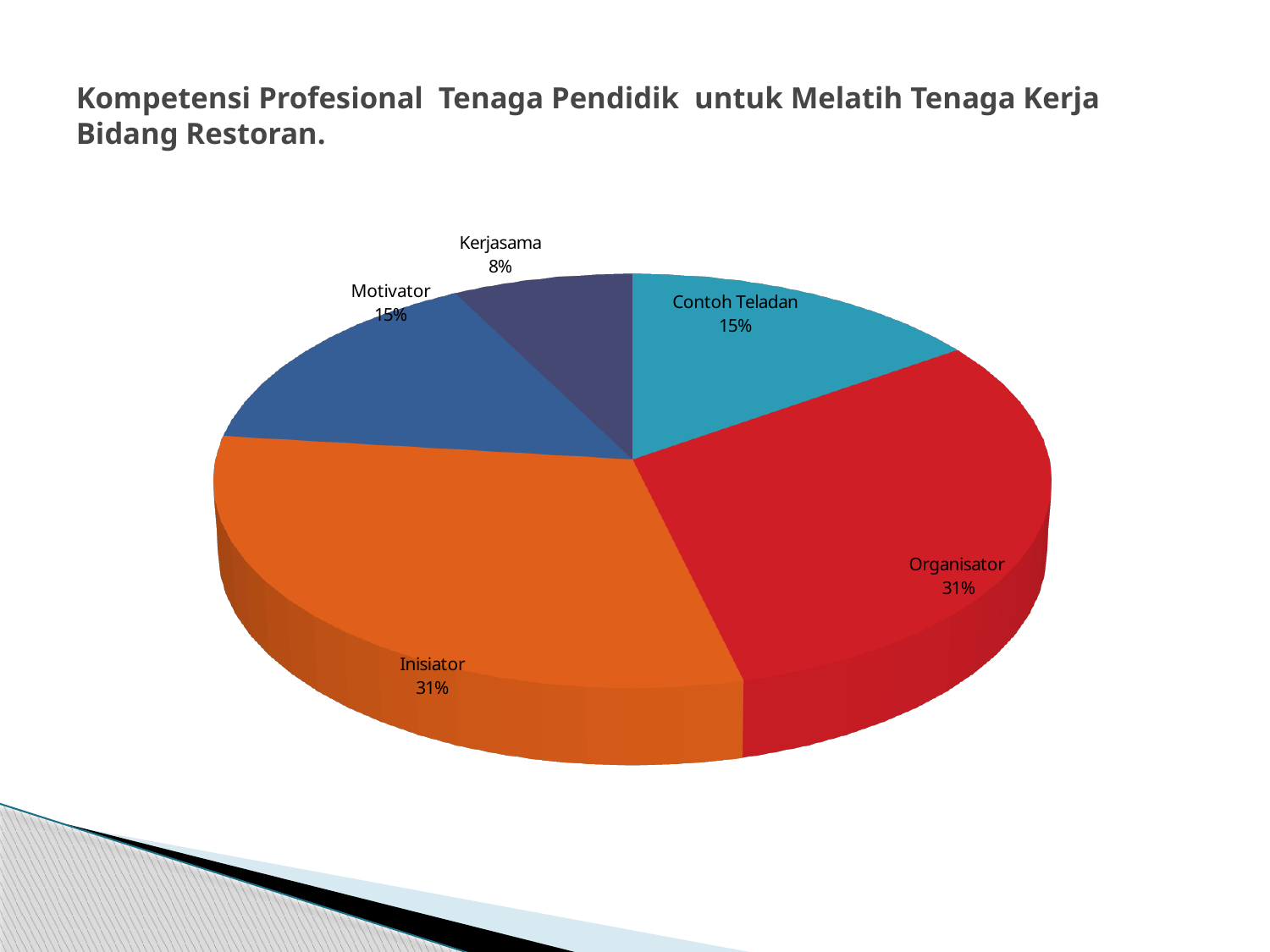
What share of the pie does Kerjasama represent? 8% How many categories are shown in the pie chart? 5 What is the value shown for Organisator? 31% Which is larger, the slice for Motivator or the slice for Inisiator? Inisiator Which category has the smallest slice of the pie? Kerjasama What is the value shown for Motivator? 15% Which is larger, the slice for Organisator or the slice for Kerjasama? Organisator What percentage is shown for Contoh Teladan? 15% What is the difference in percentage points between Inisiator and Kerjasama? 23 What kind of chart is shown on the slide? Pie chart What is the difference in percentage points between Organisator and Contoh Teladan? 16 What share of the pie does Inisiator represent? 31%